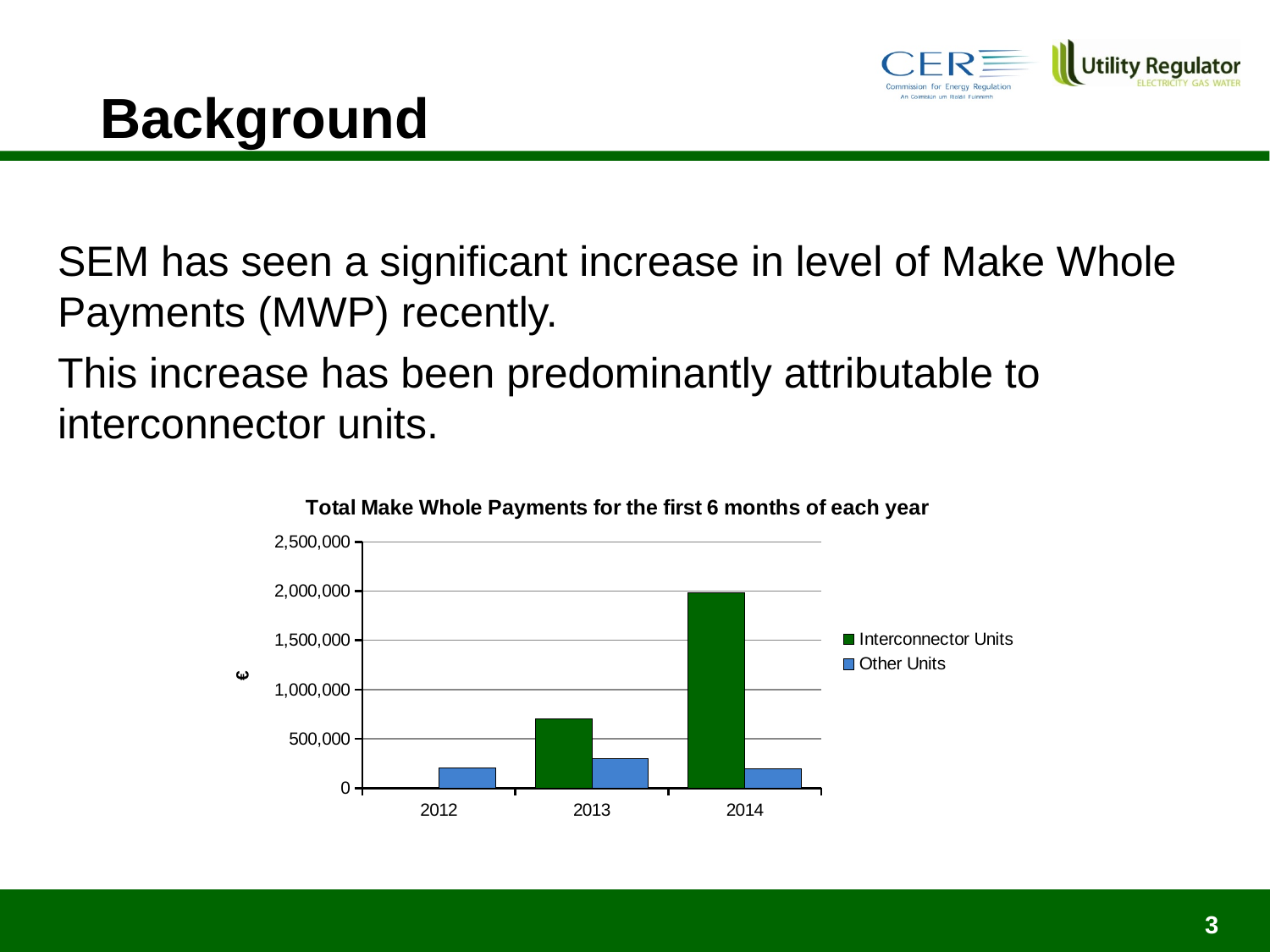
How many series does the legend list? 2 Do the values for Interconnector Units rise or fall from 2012 to 2014? rise What kind of chart is shown on the slide? bar chart Is the value for Interconnector Units in 2013 greater or less than 1,000,000? less Which year has the highest value for Other Units? 2013 Which colour represents Other Units in the chart? blue What is the title of the chart? Total Make Whole Payments for the first 6 months of each year How many years are shown on the x axis of the chart? 3 Is the value for Other Units in 2013 greater or less than 500,000? less Is the value for Interconnector Units in 2014 greater or less than 1,500,000? greater Which year has the highest value for Interconnector Units? 2014 In 2014, which series has the larger value, Interconnector Units or Other Units? Interconnector Units